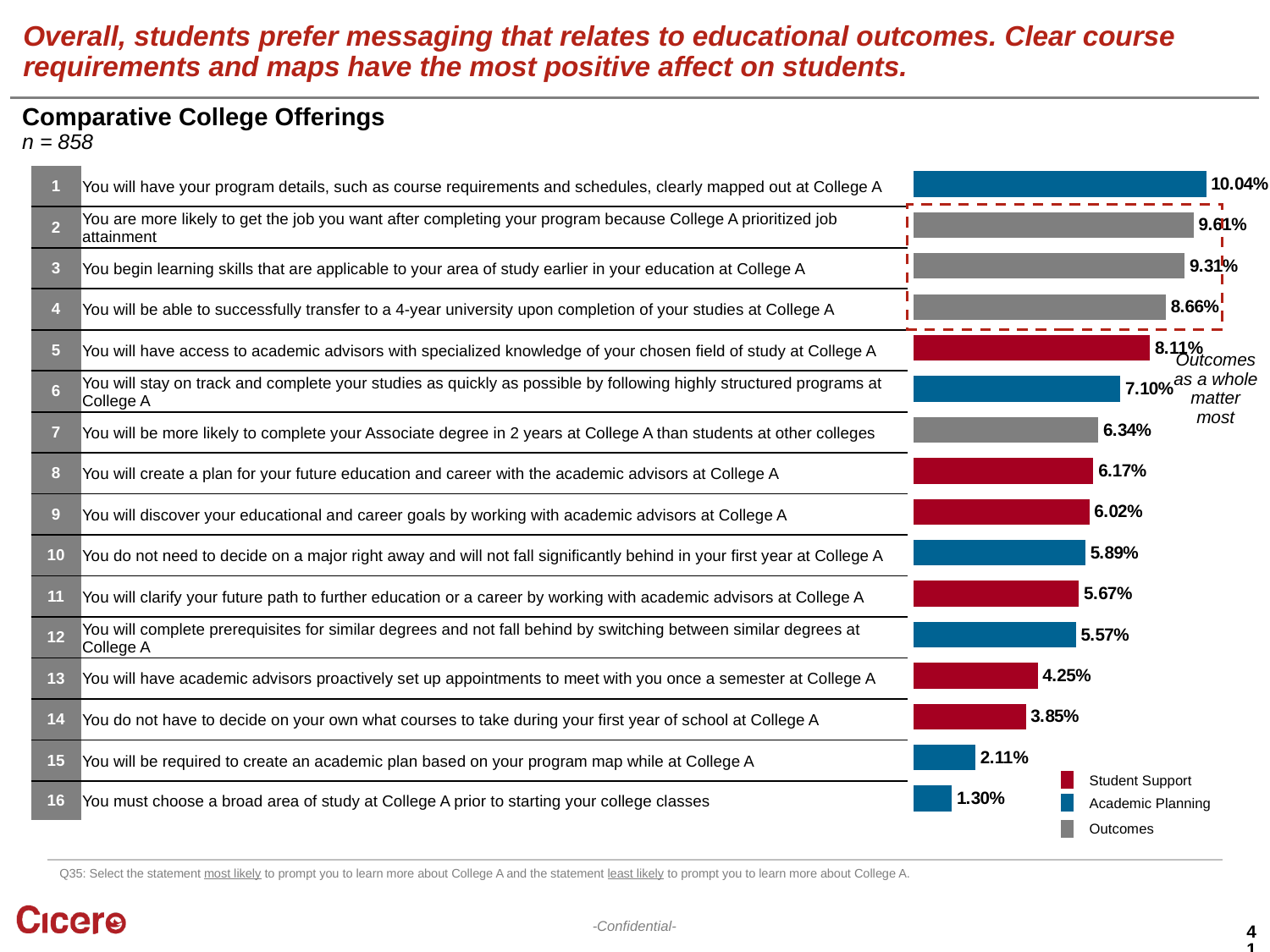
What is the value for statement 5, about access to academic advisors with specialized knowledge of your chosen field of study? 8.11% Which statement has the highest value in the chart? Statement 1 (program details clearly mapped out at College A) Which statement has the lowest value in the chart? Statement 16 (must choose a broad area of study prior to starting classes) What is the difference between the values for statement 1 (10.04%) and statement 2 (9.61%)? 0.43% How many statements are plotted in the chart? 16 Which has a larger value: statement 7 (completing an Associate degree in 2 years) or statement 13 (advisors proactively setting up appointments)? Statement 7 What is the value for statement 1, "You will have your program details, such as course requirements and schedules, clearly mapped out at College A"? 10.04% Which legend category do the gray bars represent? Outcomes What is the value for statement 16, "You must choose a broad area of study at College A prior to starting your college classes"? 1.30% What type of chart is shown on the slide? Bar chart What is the sample size (n) shown under the chart title "Comparative College Offerings"? 858 How many categories does the legend list? 3